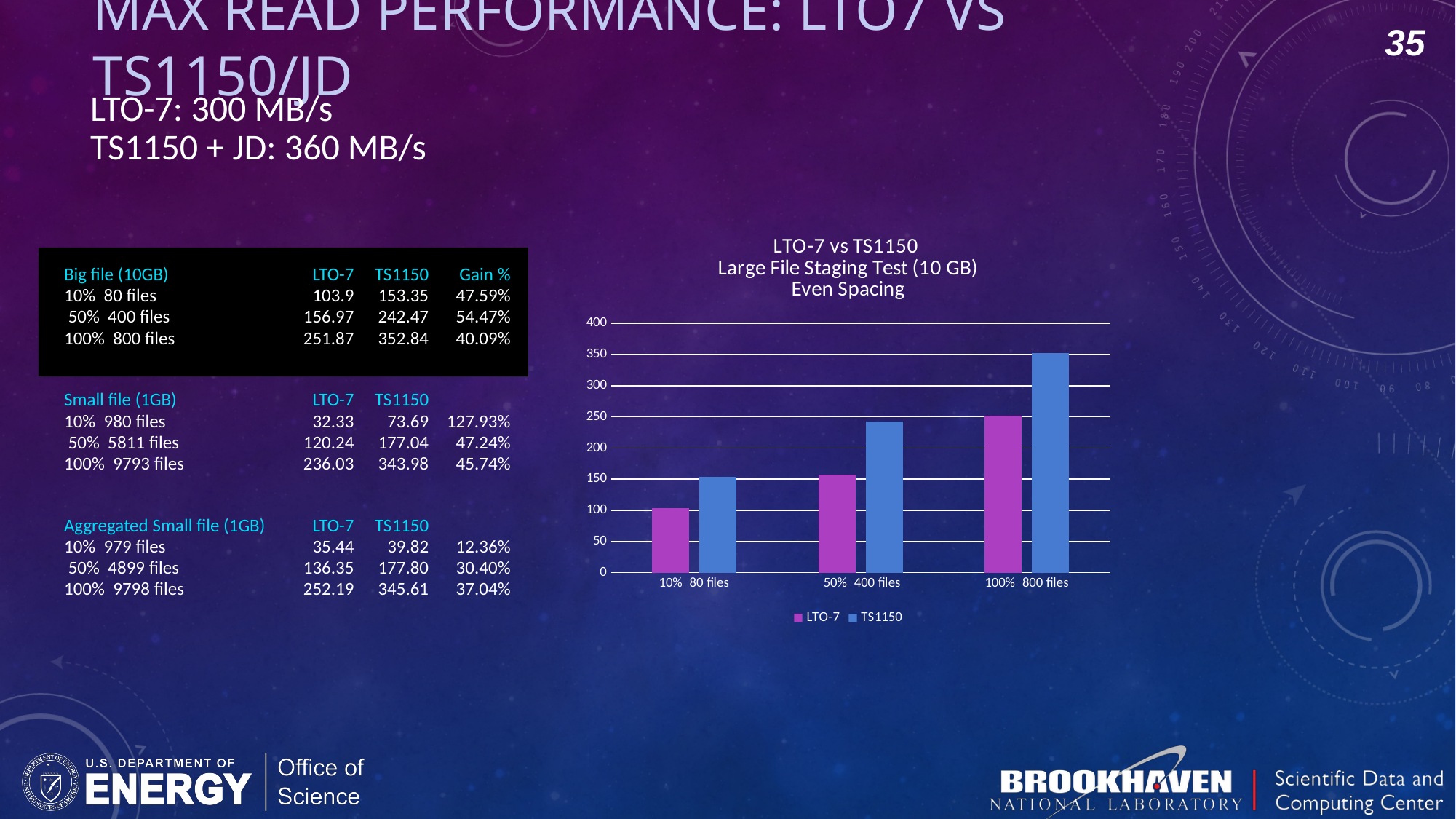
Which colour represents the TS1150 series in the chart? blue In the chart, is the TS1150 bar for 50% 400 files greater or less than 200? greater In the chart, is the LTO-7 bar for 50% 400 files greater or less than 200? less Do the LTO-7 bars rise or fall from left to right across the x axis? rise How many categories are shown on the x axis of the chart? 3 In the chart, which is larger for 10% 80 files: the LTO-7 bar or the TS1150 bar? TS1150 Which category has the highest TS1150 bar in the chart? 100% 800 files What is the title of the chart? LTO-7 vs TS1150 Large File Staging Test (10 GB) Even Spacing What kind of chart is shown on the slide? bar chart In the chart, is the TS1150 bar for 100% 800 files greater or less than 300? greater How many series does the chart legend list? 2 Which category has the lowest LTO-7 bar in the chart? 10% 80 files